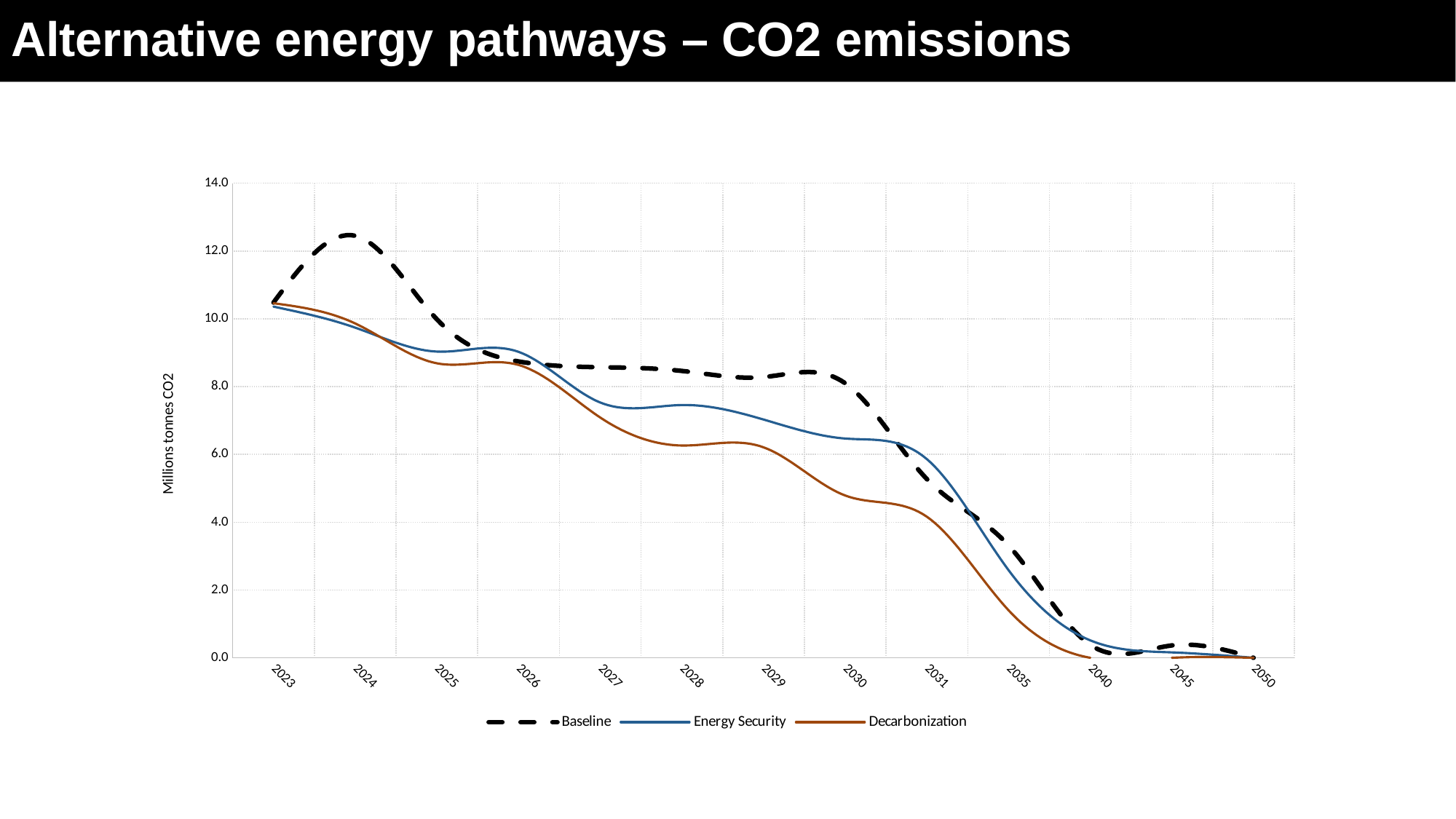
In 2029, which is larger: Energy Security or Decarbonization? Energy Security What kind of chart is shown on the slide? line chart What is the label on the vertical axis? Millions tonnes CO2 How many series does the legend list? 3 Which series has the highest value in 2028? Baseline How many years are labelled along the x axis? 13 Does the Decarbonization series rise or fall from 2023 to 2050? fall Which series has the lowest value in 2030? Decarbonization Is the Decarbonization value in 2040 greater or less than 2.0? less Is the Energy Security value in 2028 greater or less than 8.0? less Which series is drawn as a dashed line? Baseline Is the Baseline value in 2024 greater or less than 10.0? greater